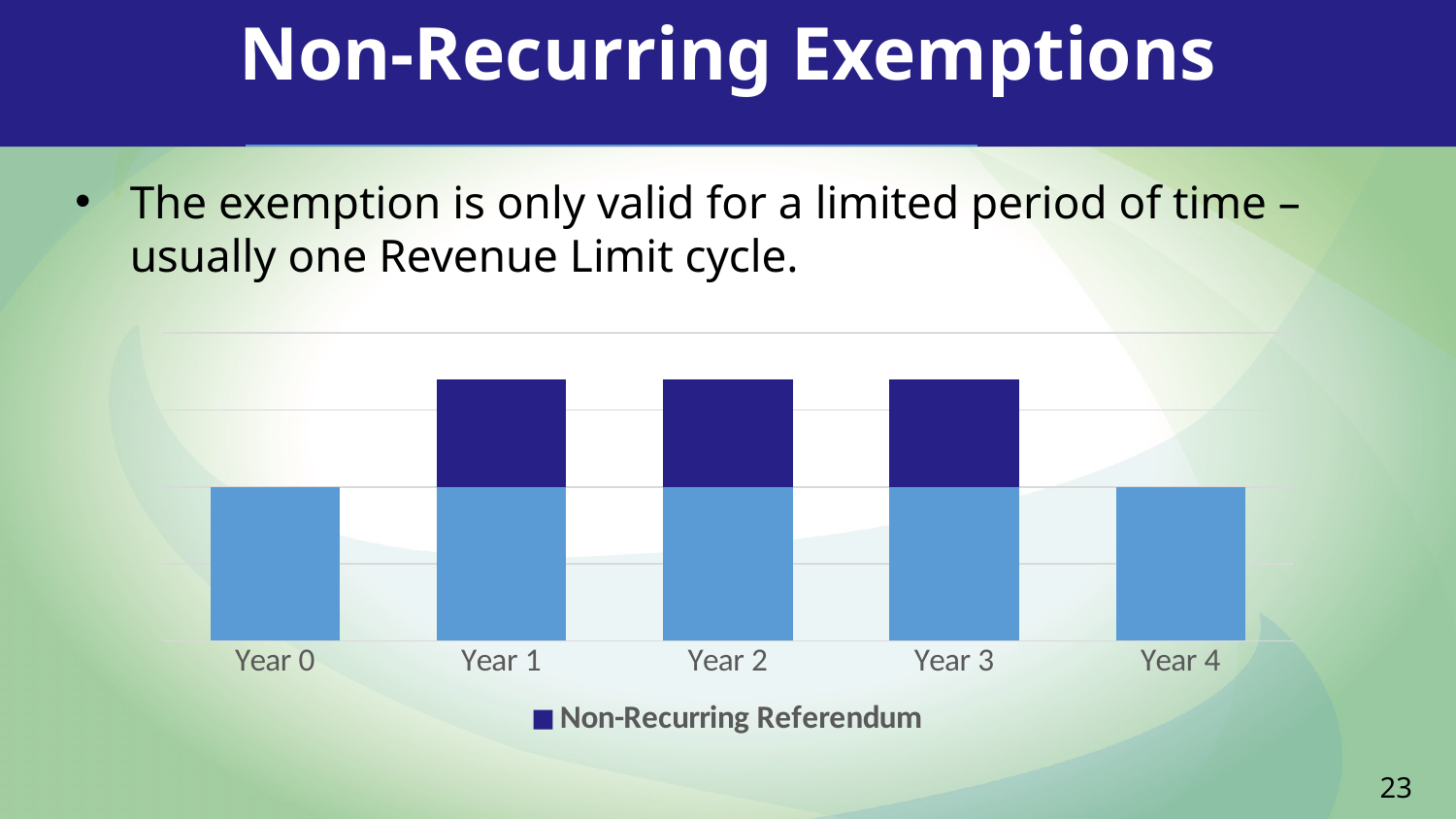
How many series does the chart's legend list? 1 What series name appears in the chart's legend? Non-Recurring Referendum Does the Year 4 bar include a Non-Recurring Referendum segment? No What is the label of the last category on the x axis? Year 4 How many bars include a dark blue Non-Recurring Referendum segment? 3 Which of the two bars is taller, Year 2 or Year 4? Year 2 What kind of chart is shown on the slide? Stacked bar chart Which years have a Non-Recurring Referendum segment stacked on top of the bar? Year 1, Year 2, Year 3 What is the label of the first category on the x axis? Year 0 How many categories are shown on the x axis of the chart? 5 Which of the two bars is taller, Year 0 or Year 1? Year 1